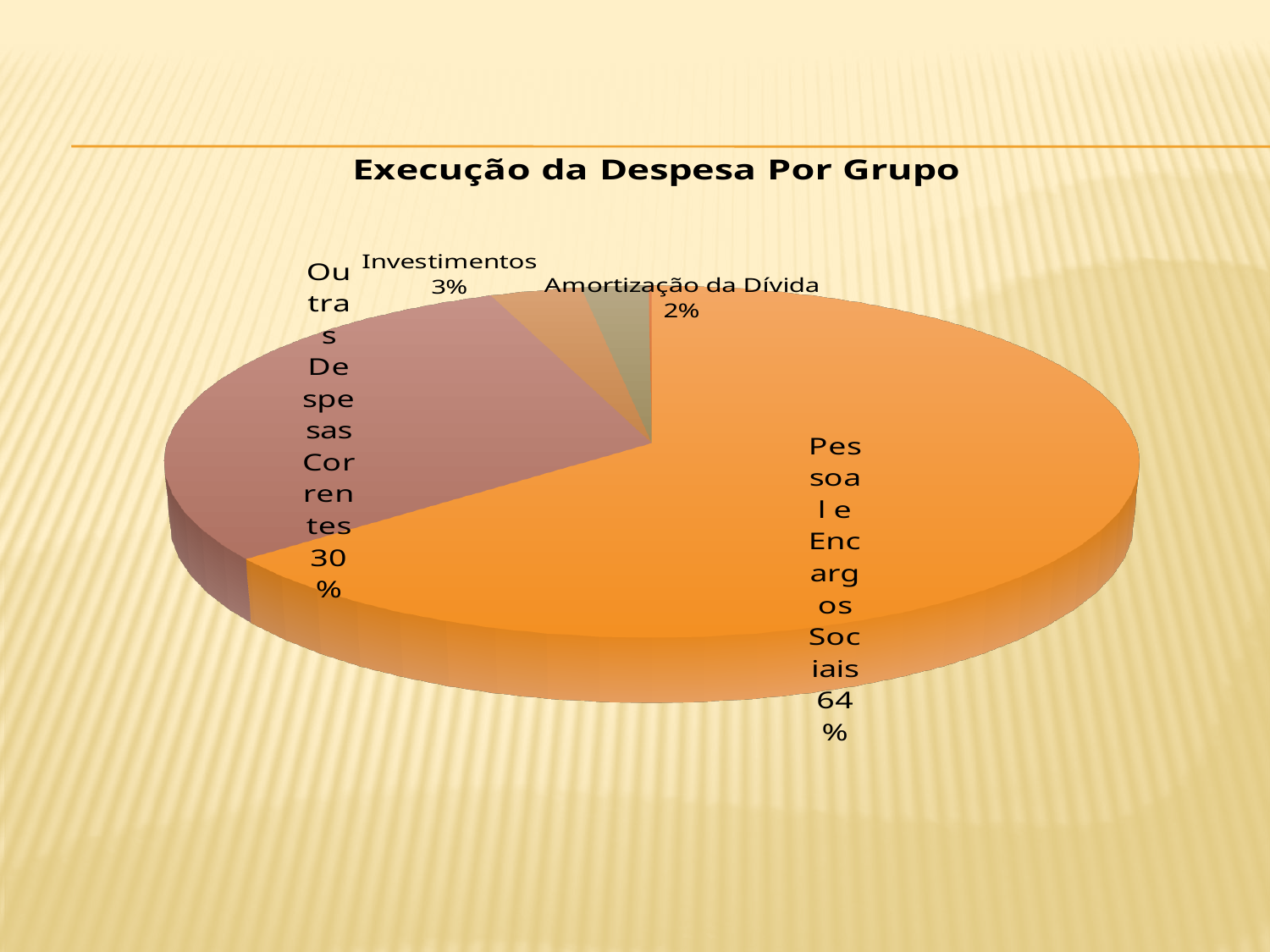
What is the value shown for Amortização da Dívida? 2% What is the difference in percentage points between Outras Despesas Correntes and Investimentos? 27 Which category has the largest slice of the pie? Pessoal e Encargos Sociais What is the difference in percentage points between Pessoal e Encargos Sociais and Outras Despesas Correntes? 34 What is the value shown for Investimentos? 3% What share of the pie does Pessoal e Encargos Sociais represent? 64% What share of the pie does Outras Despesas Correntes represent? 30% How many categories are shown in the pie chart? 4 What kind of chart is shown on the slide? pie chart Which category has the smallest slice of the pie? Amortização da Dívida What is the title of the chart? Execução da Despesa Por Grupo Which is larger, Investimentos or Amortização da Dívida? Investimentos